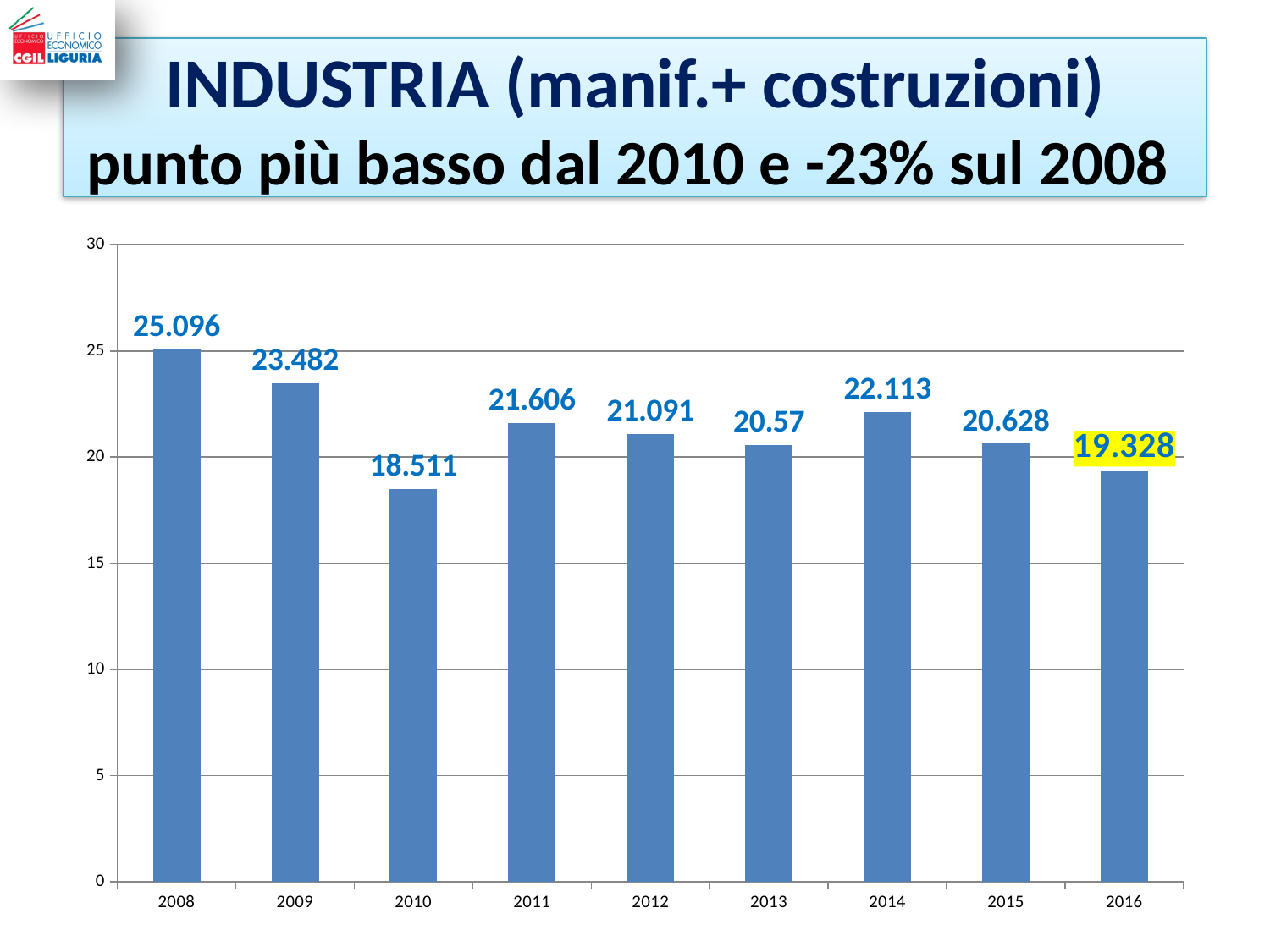
What kind of chart is shown on the slide? bar chart What is the value for 2016? 19.328 What is the value for 2013? 20.57 Which year's data label is highlighted in yellow? 2016 Which year has the highest value? 2008 Which is larger, the value for 2011 or the value for 2014? 2014 Which year has the lowest value? 2010 What is the difference between the values for 2008 and 2016? 5.768 Does the value rise or fall from 2014 to 2016? fall Is the value for 2010 greater or less than 20? less What is the value for 2008? 25.096 How many years are shown on the x axis? 9